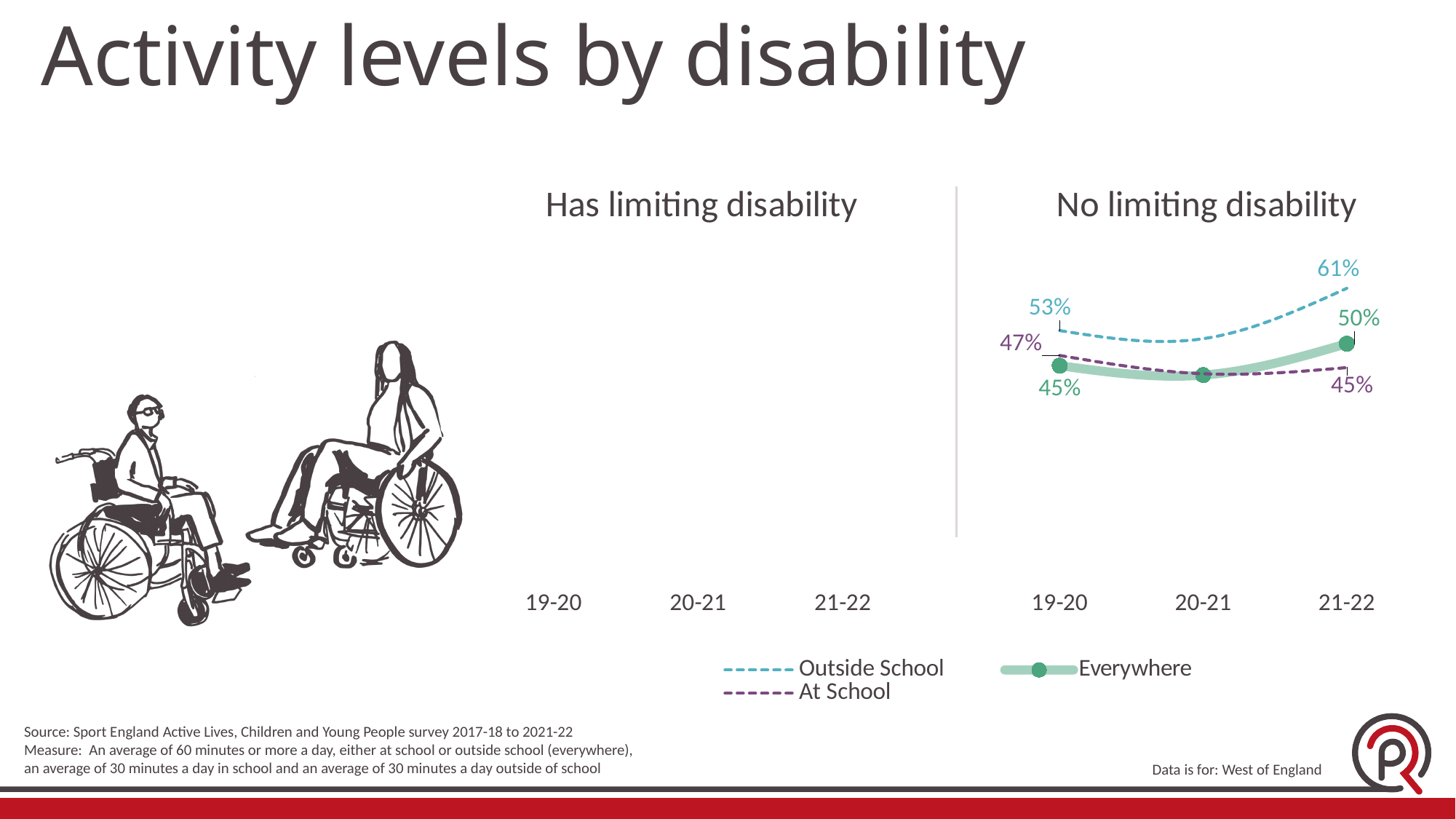
In the No limiting disability chart, what is the At School value for 19-20? 47% In the No limiting disability chart, what is the Outside School value for 21-22? 61% In the No limiting disability chart, which series has the highest value in 21-22? Outside School In the No limiting disability chart, does the Everywhere series rise or fall from 19-20 to 21-22? rise In the No limiting disability chart, what is the Everywhere value for 19-20? 45% In the No limiting disability chart, by how many percentage points did the Outside School value change from 19-20 to 21-22? 8 percentage points In the No limiting disability chart, what is the At School value for 21-22? 45% In the No limiting disability chart, what is the Outside School value for 19-20? 53% In the No limiting disability chart, what is the Everywhere value for 21-22? 50% How many series does the legend list? 3 In the No limiting disability chart, which is larger in 21-22: Everywhere or At School? Everywhere What type of chart is used for the No limiting disability panel? line chart